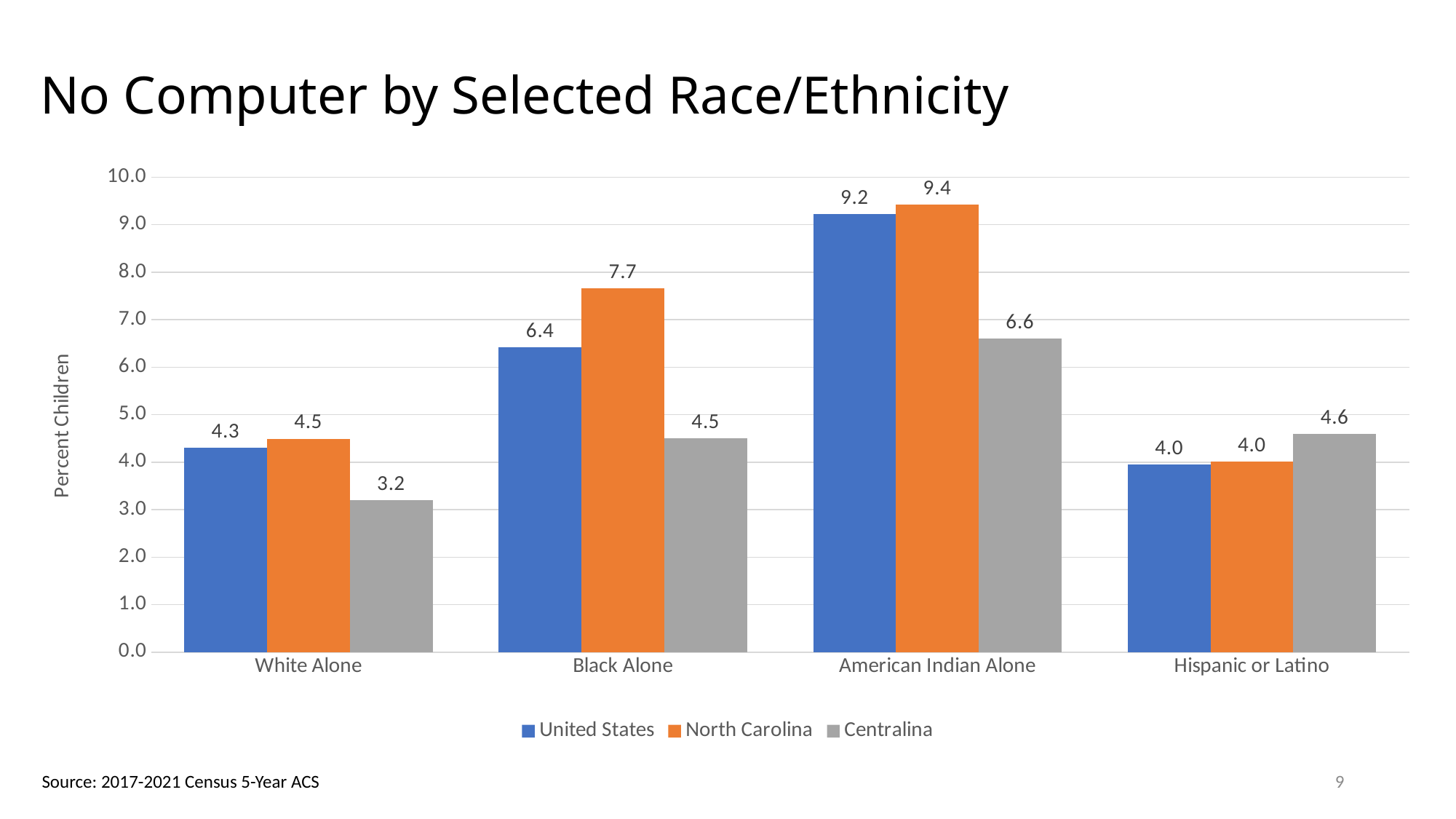
Is the value for North Carolina in the American Indian Alone category greater or less than 9.0? greater Which is larger in the Hispanic or Latino category: the United States value or the Centralina value? Centralina Which category has the lowest value for the United States? Hispanic or Latino What is the difference between the North Carolina and Centralina values in the Black Alone category? 3.2 How many race/ethnicity categories are shown on the x axis? 4 What kind of chart is shown on the slide? bar chart What is the value for the United States in the American Indian Alone category? 9.2 What is the label on the vertical axis? Percent Children What is the value for North Carolina in the Black Alone category? 7.7 What is the value for Centralina in the White Alone category? 3.2 How many series does the legend list? 3 Which category has the highest value for Centralina? American Indian Alone